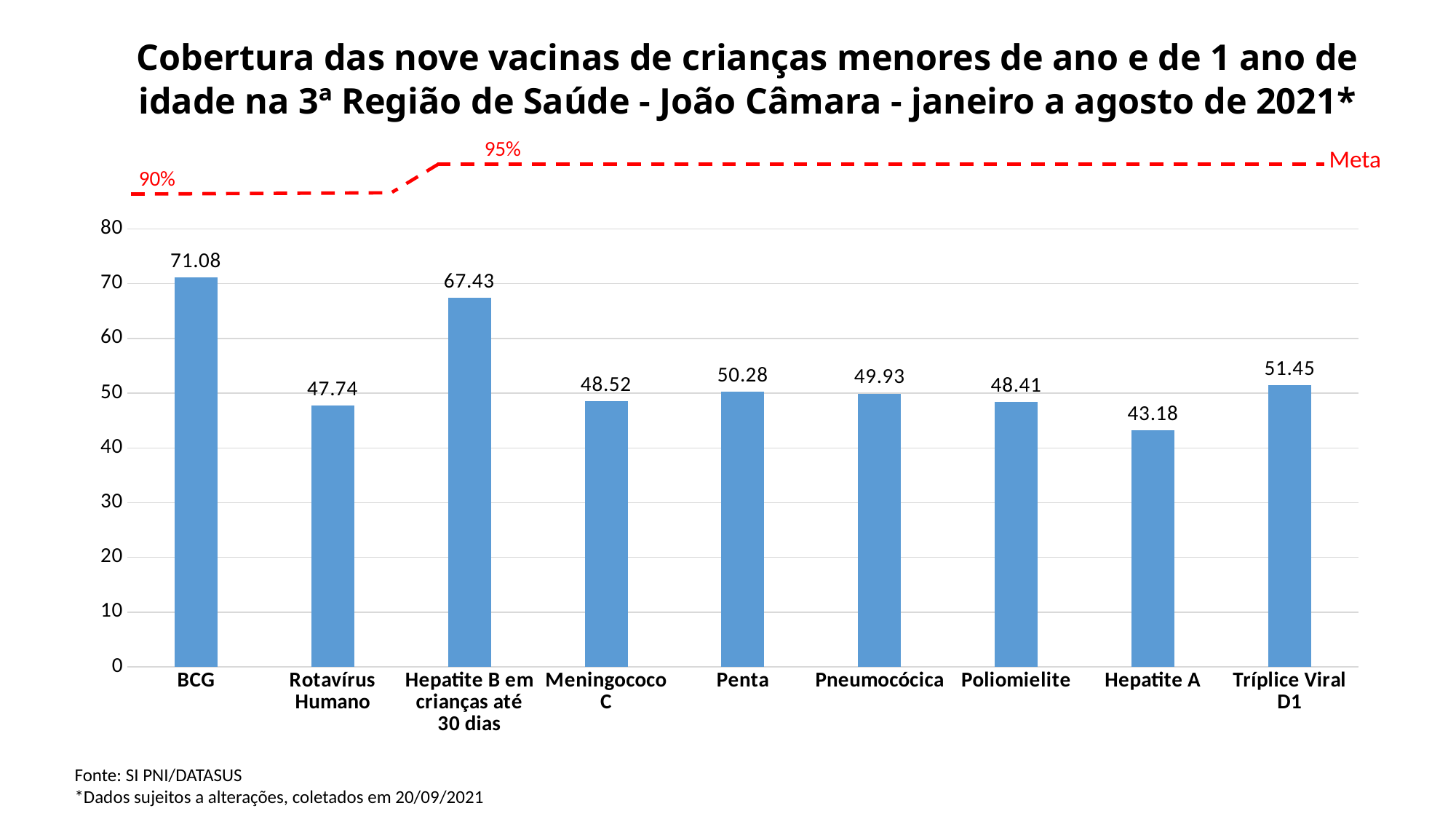
Which vaccine has the lowest coverage value? Hepatite A What is the value for Penta? 50.28 What is the value for BCG? 71.08 What is the label of the red dashed line at the top of the chart? Meta Is the value for Pneumocócica greater or less than 40? greater What is the difference between the values for BCG and Hepatite B em crianças até 30 dias? 3.65 Which is larger, the value for Rotavírus Humano or the value for Meningococo C? Meningococo C What is the value for Hepatite A? 43.18 What is the value for Tríplice Viral D1? 51.45 What kind of chart is shown on the slide? bar chart How many vaccines are shown on the x axis? 9 Which vaccine has the highest coverage value? BCG